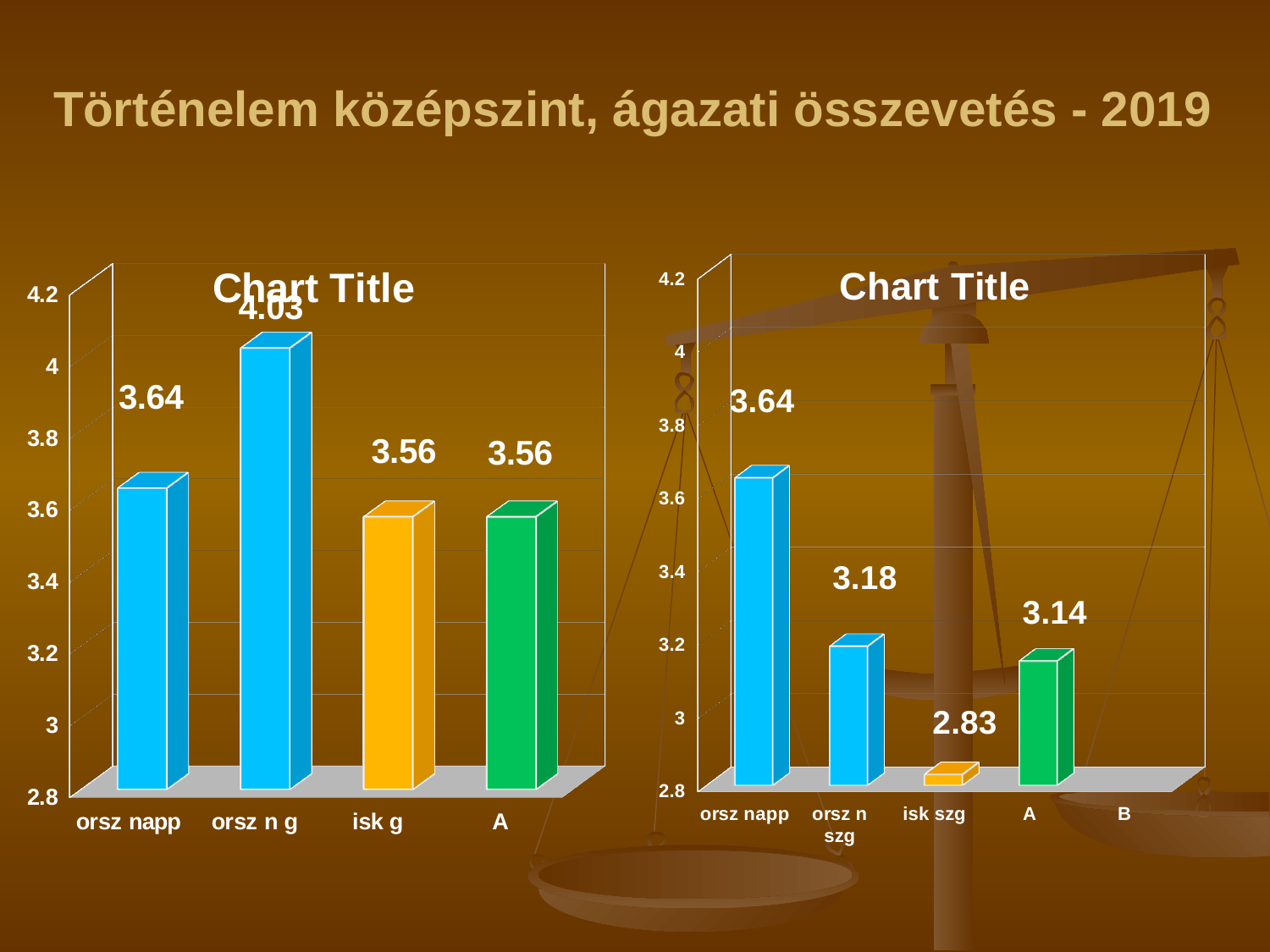
In the left chart, what is the difference between orsz n g and orsz napp? 0.39 In the right chart, what is the difference between orsz napp and isk szg? 0.81 In the left chart, what is the value for orsz n g? 4.03 In the right chart, which category has the highest value? orsz napp In the left chart, which category has the highest value? orsz n g In the left chart, what is the value for isk g? 3.56 In the right chart, which is larger, orsz n szg or A? orsz n szg In the right chart, what is the value for isk szg? 2.83 In the right chart, what is the value for A? 3.14 What type of chart is the left chart? bar chart In the left chart, how many categories are shown on the x axis? 4